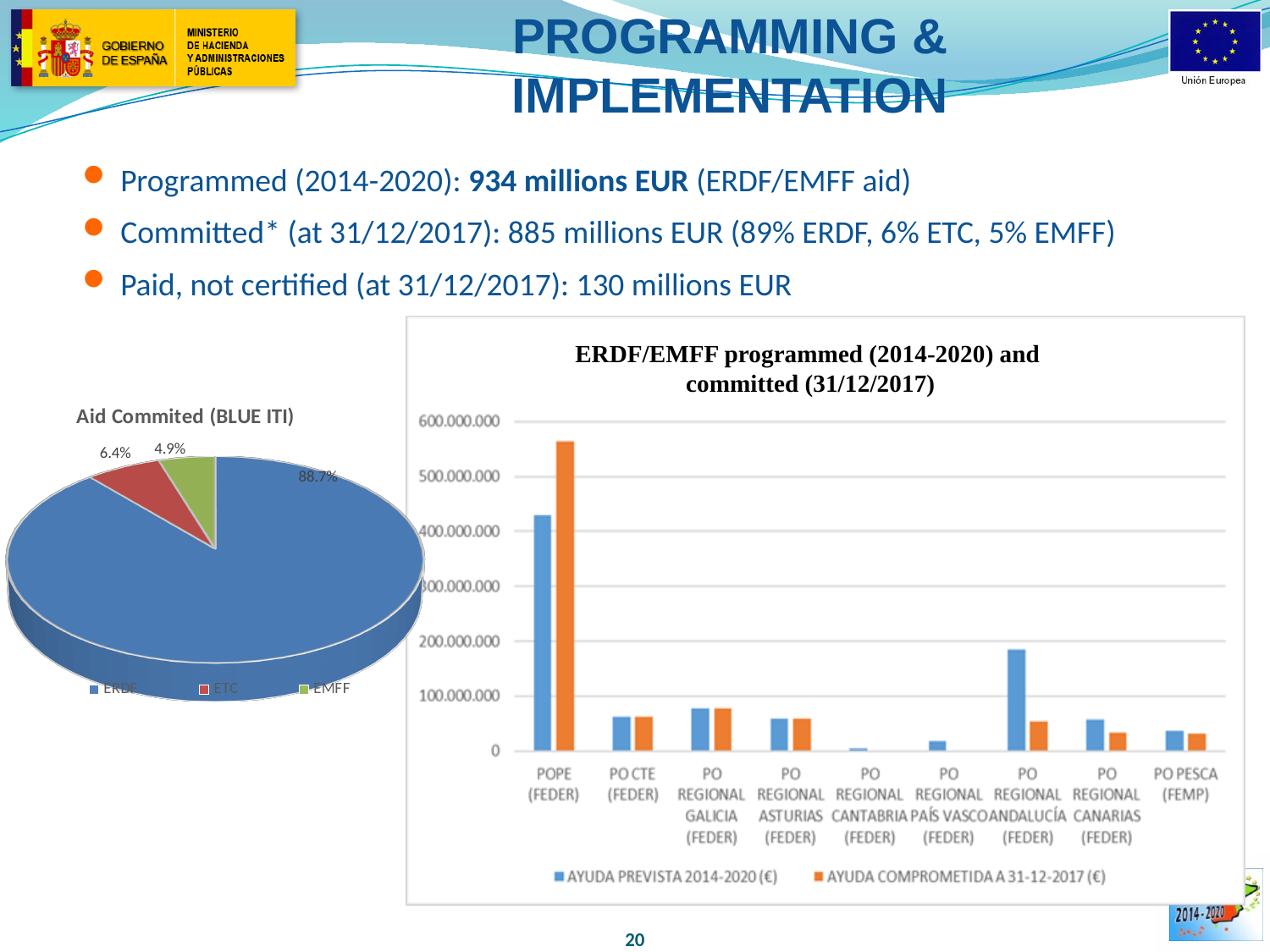
How many categories are shown on the x axis of the 'ERDF/EMFF programmed (2014-2020) and committed (31/12/2017)' chart? 9 How many series does the legend of the 'ERDF/EMFF programmed (2014-2020) and committed (31/12/2017)' chart list? 2 In the 'Aid Commited (BLUE ITI)' pie chart, what share does ERDF have? 88.7% In the 'ERDF/EMFF programmed (2014-2020) and committed (31/12/2017)' chart, for PO REGIONAL ANDALUCÍA (FEDER), which is larger: AYUDA PREVISTA 2014-2020 (€) or AYUDA COMPROMETIDA A 31-12-2017 (€)? AYUDA PREVISTA 2014-2020 (€) How many slices does the 'Aid Commited (BLUE ITI)' pie chart have? 3 In the 'ERDF/EMFF programmed (2014-2020) and committed (31/12/2017)' chart, which category has the highest AYUDA COMPROMETIDA A 31-12-2017 (€) value? POPE (FEDER) In the 'Aid Commited (BLUE ITI)' pie chart, what share does ETC have? 6.4% In the 'Aid Commited (BLUE ITI)' pie chart, which slice is the smallest? EMFF What type of chart is the 'ERDF/EMFF programmed (2014-2020) and committed (31/12/2017)' chart? Bar chart In the 'Aid Commited (BLUE ITI)' pie chart, what share does EMFF have? 4.9% In the 'Aid Commited (BLUE ITI)' pie chart, what is the difference between the ETC share and the EMFF share? 1.5% In the 'ERDF/EMFF programmed (2014-2020) and committed (31/12/2017)' chart, is the AYUDA PREVISTA 2014-2020 (€) value for POPE (FEDER) greater or less than 400.000.000? greater